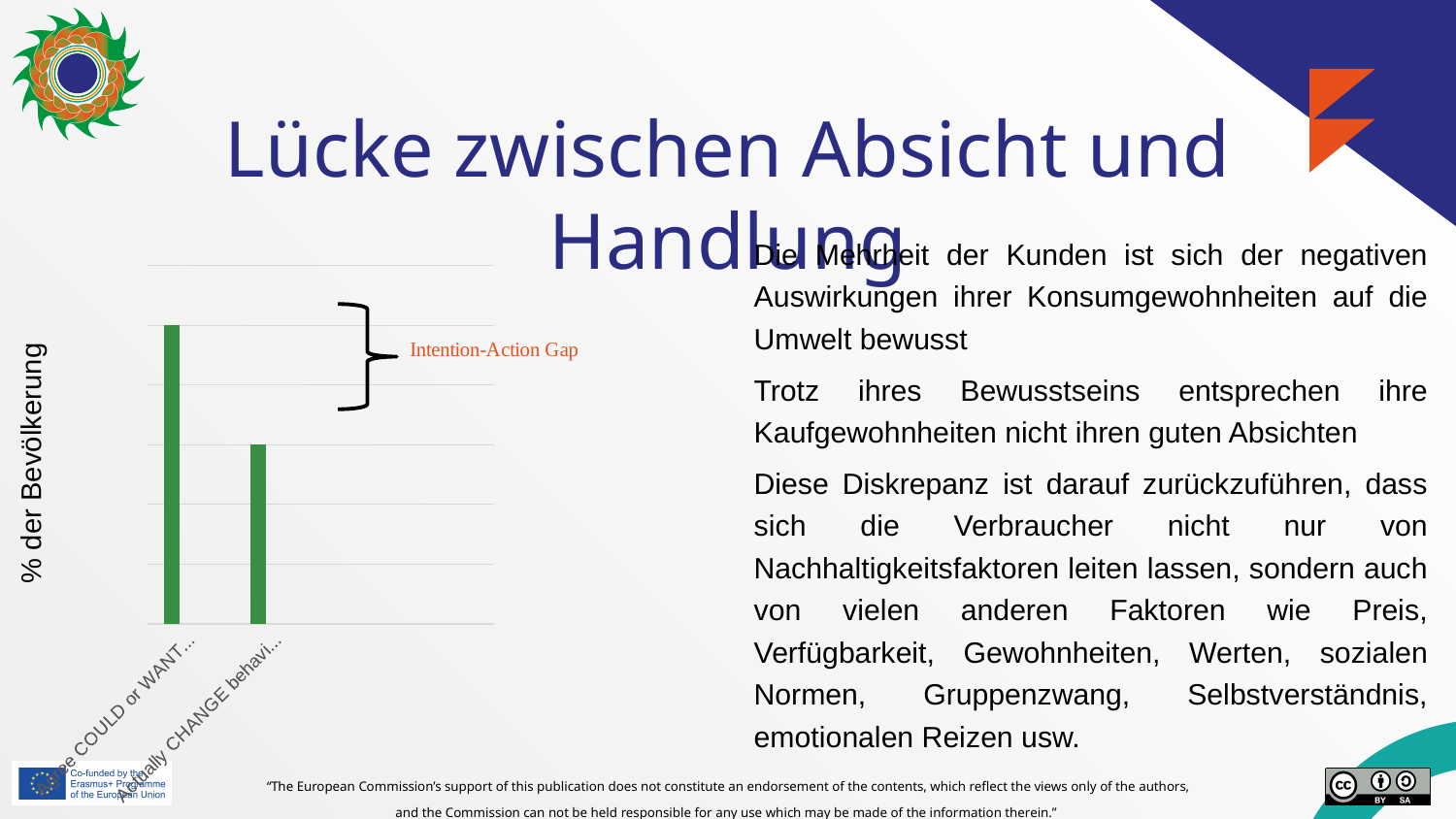
What kind of chart is shown on the left of the slide? bar chart What text does the bracket annotation next to the bars read? Intention-Action Gap Do the bar values rise or fall from left to right across the chart? fall Which bar in the chart is the highest? the left bar How many bars are plotted in the chart? 2 Which bar is taller, the left bar or the right bar? the left bar What is the label on the vertical axis of the chart? % der Bevölkerung Which bar in the chart is the lowest? the right bar